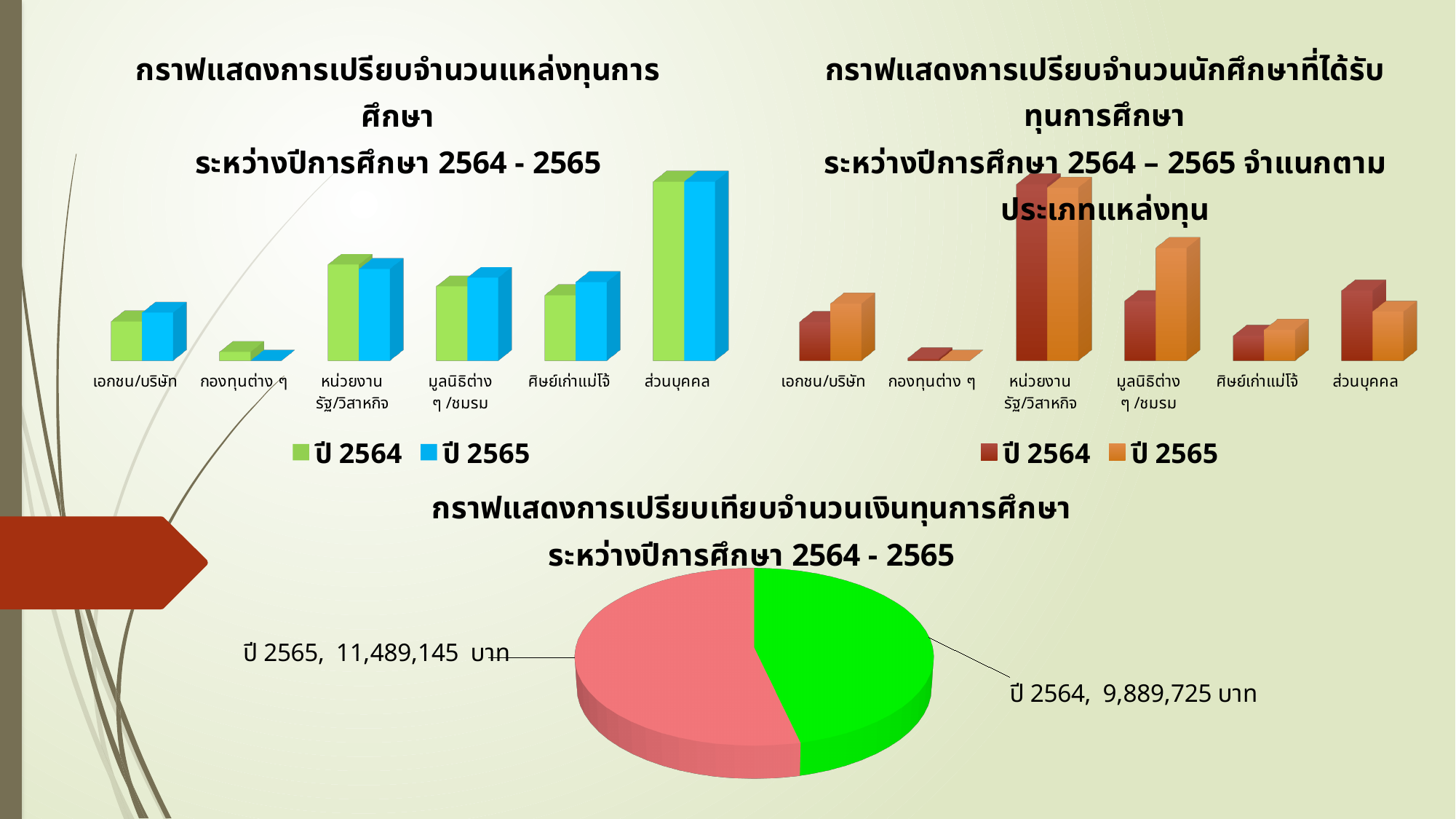
In the bottom pie chart, what is the difference between the ปี 2565 value and the ปี 2564 value? 1,599,420 บาท In the top-left bar chart, how many categories are shown on the x axis? 6 What kind of chart is the chart titled 'กราฟแสดงการเปรียบจำนวนแหล่งทุนการศึกษา ระหว่างปีการศึกษา 2564 - 2565' (top left)? Bar chart In the top-right bar chart, for ส่วนบุคคล, which year has the larger value, ปี 2564 or ปี 2565? ปี 2564 What kind of chart is the chart titled 'กราฟแสดงการเปรียบเทียบจำนวนเงินทุนการศึกษา ระหว่างปีการศึกษา 2564 - 2565' (bottom)? Pie chart In the top-right bar chart, which category has the highest bars? หน่วยงานรัฐ/วิสาหกิจ In the top-left bar chart, which category has the lowest bars? กองทุนต่าง ๆ In the bottom pie chart, what is the value for ปี 2565? 11,489,145 บาท In the top-left bar chart, which category has the highest bars? ส่วนบุคคล In the top-right bar chart, how many series does the legend list? 2 In the bottom pie chart, what is the value for ปี 2564? 9,889,725 บาท In the top-right bar chart, for มูลนิธิต่าง ๆ /ชมรม, which year has the larger value, ปี 2564 or ปี 2565? ปี 2565